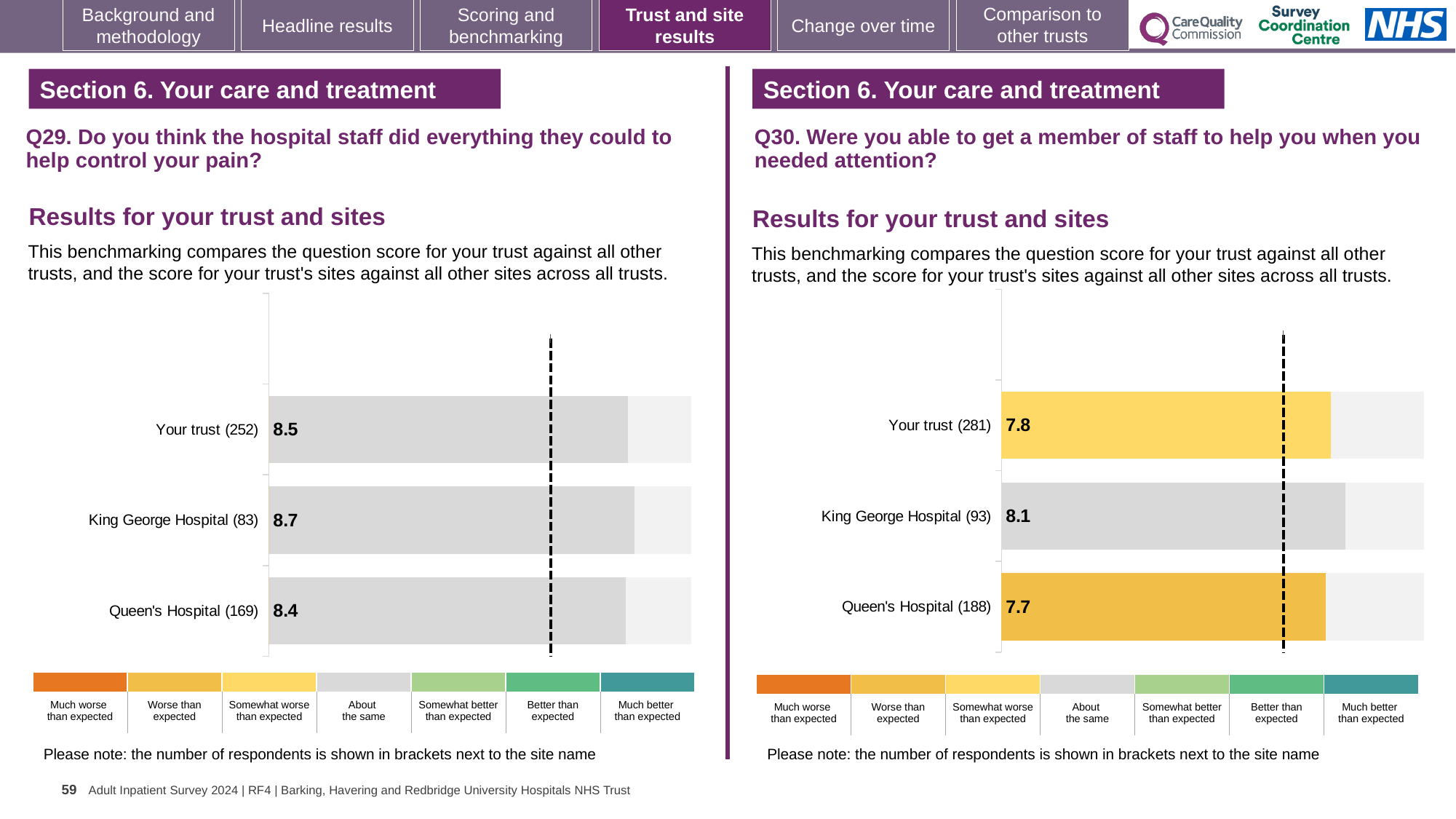
In the Q29 chart on the left, what is the difference between the scores for King George Hospital and Queen's Hospital? 0.3 How many bars are plotted in the Q29 chart on the left? 3 In the Q30 chart on the right, what is the difference between the scores for King George Hospital and Your trust? 0.3 In the Q30 chart on the right, which site or trust has the highest score? King George Hospital (93) In the Q30 chart on the right, what is the score for Your trust (281)? 7.8 In the Q30 chart on the right, which has the larger score: Your trust or King George Hospital? King George Hospital In the Q30 chart on the right, what is the score for Queen's Hospital (188)? 7.7 What type of chart is used in the Q30 chart on the right? Bar chart In the Q29 chart on the left, what is the score for Your trust (252)? 8.5 In the Q30 chart on the right, what benchmark category does the colour of the Queen's Hospital bar indicate? Worse than expected In the Q29 chart on the left, which site or trust has the lowest score? Queen's Hospital (169) In the Q29 chart on the left, what is the score for King George Hospital (83)? 8.7